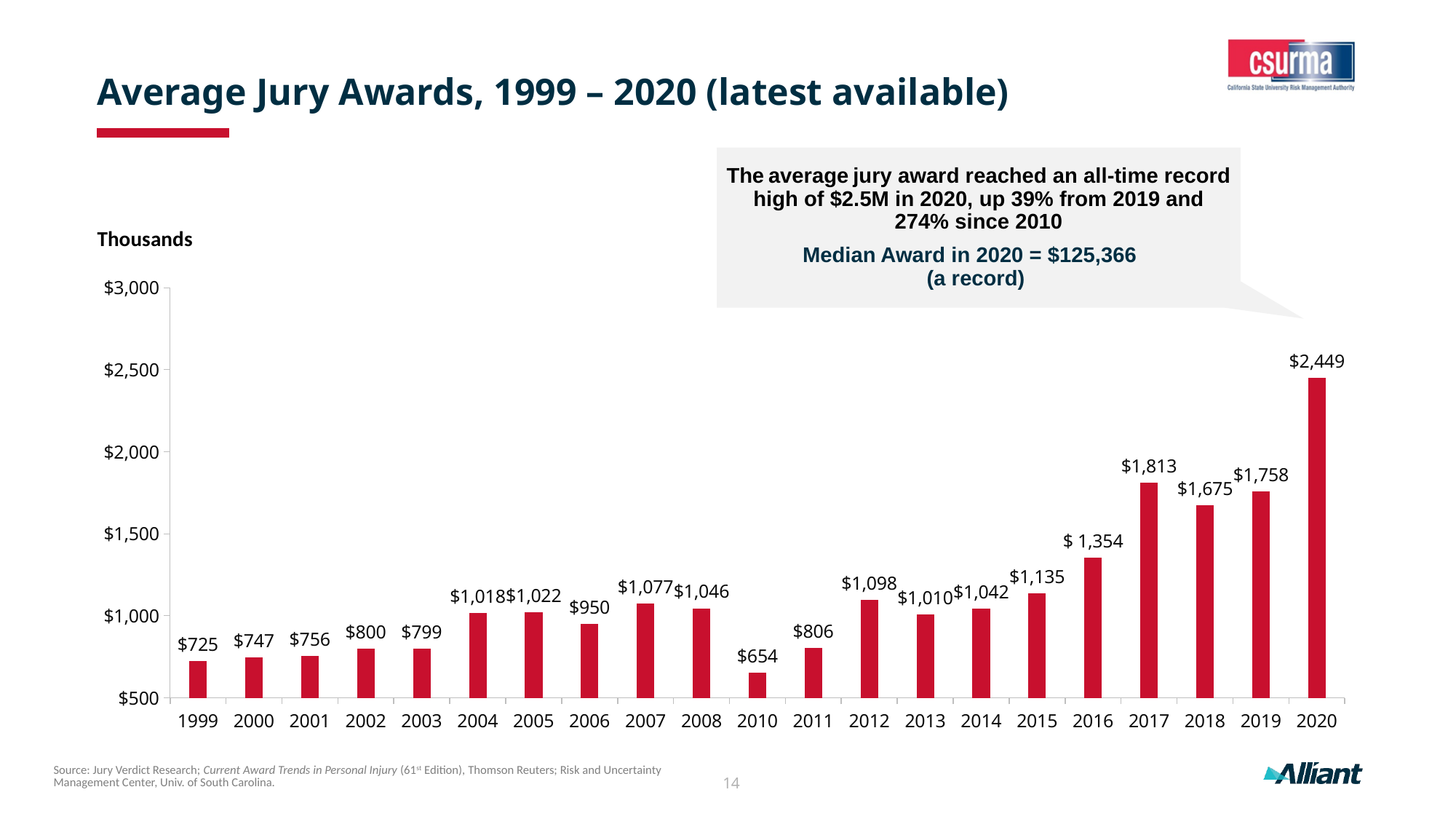
How many years are plotted on the chart? 21 What is the value shown for 2010? $654 What kind of chart is shown on the slide? bar chart What is the difference between the values for 2017 and 2018? $138 Which year has the lowest average jury award? 2010 Is the value for 2016 greater or less than $1,500? less Which is larger, the value for 2004 or the value for 2006? 2004 What is the difference between the values for 2020 and 2019? $691 What is the average jury award shown for 2020? $2,449 What unit label is shown above the vertical axis? Thousands What is the value shown for 2007? $1,077 Which year has the highest average jury award? 2020